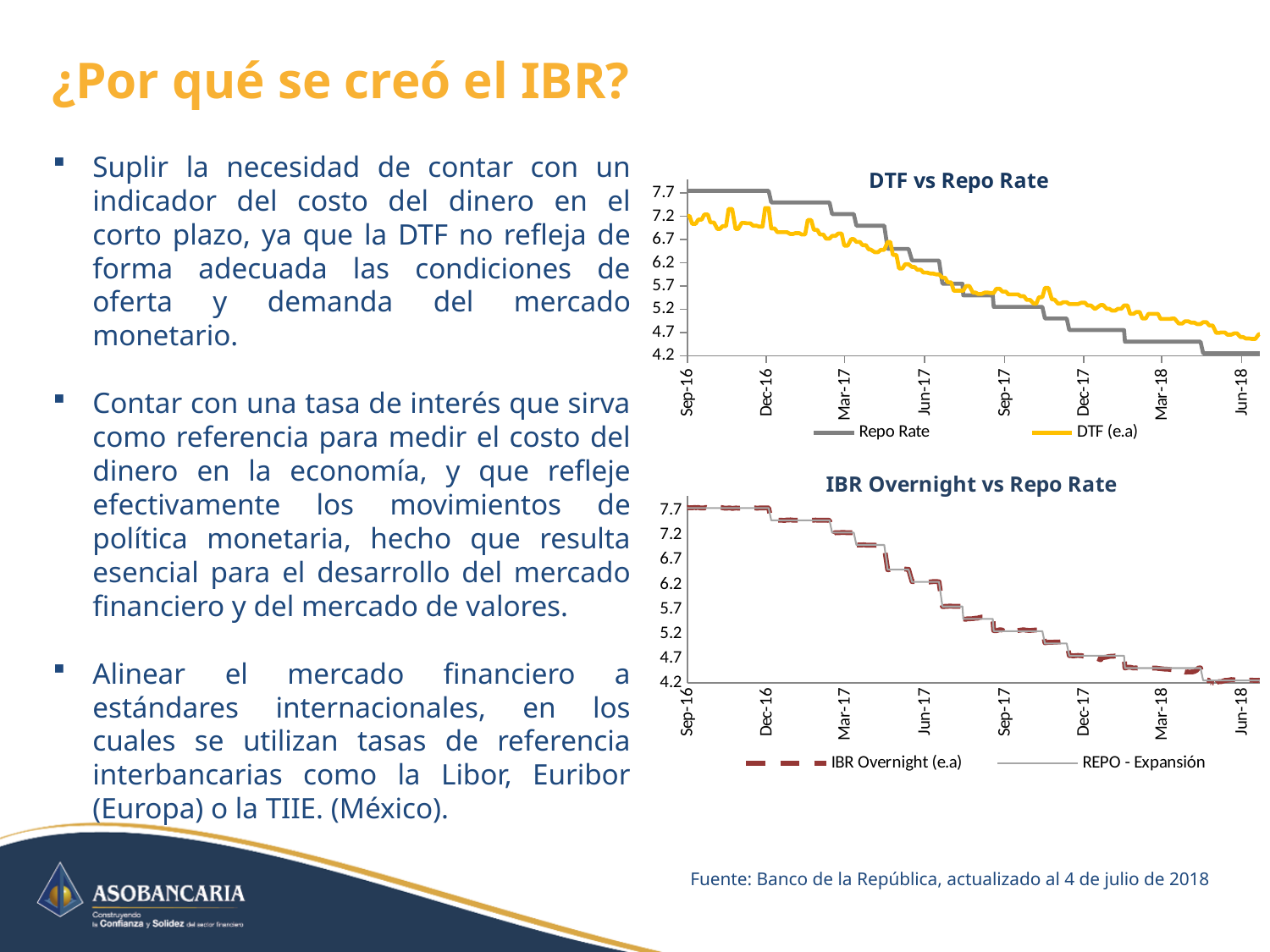
In the 'DTF vs Repo Rate' chart, which series is higher at Jun-18, Repo Rate or DTF (e.a)? DTF (e.a) What are the two legend entries of the 'IBR Overnight vs Repo Rate' chart? IBR Overnight (e.a) and REPO - Expansión In the 'IBR Overnight vs Repo Rate' chart, does the IBR Overnight (e.a) series rise or fall over the period shown? fall In the 'DTF vs Repo Rate' chart, is the Repo Rate at Jun-18 greater or less than 4.7? less In the 'DTF vs Repo Rate' chart, does the Repo Rate rise or fall from Sep-16 to Jun-18? fall How many series does the legend of the 'IBR Overnight vs Repo Rate' chart list? 2 In the 'DTF vs Repo Rate' chart, which series is higher at Sep-16, Repo Rate or DTF (e.a)? Repo Rate How many series does the legend of the 'DTF vs Repo Rate' chart list? 2 What kind of chart is the 'DTF vs Repo Rate' chart? line chart In the 'DTF vs Repo Rate' chart, is the DTF (e.a) value at Sep-16 greater or less than 6.7? greater What kind of chart is the 'IBR Overnight vs Repo Rate' chart? line chart In the 'IBR Overnight vs Repo Rate' chart, is the IBR Overnight (e.a) value at Jun-18 greater or less than 4.7? less